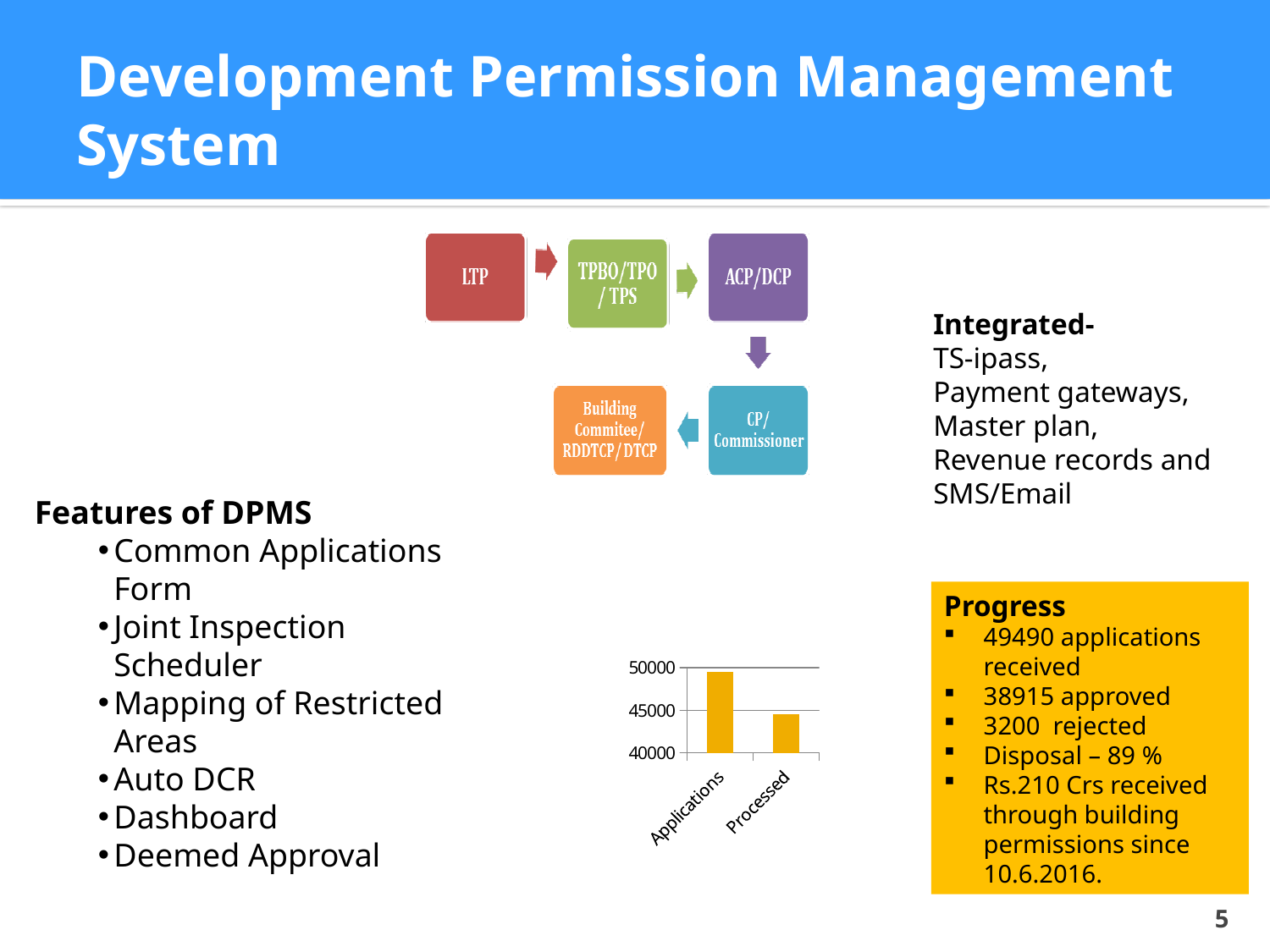
How many categories are plotted in the bar chart? 2 What colour are the bars in the chart? gold Is the value for Processed greater or less than 40000? greater What is the lowest value shown on the chart's vertical axis? 40000 What kind of chart is shown on the slide? bar chart Which category has the lowest bar in the chart? Processed Do the bar values rise or fall from Applications to Processed? fall Which is larger in the chart, Applications or Processed? Applications Which category has the highest bar in the chart? Applications Is the value for Applications greater or less than 45000? greater